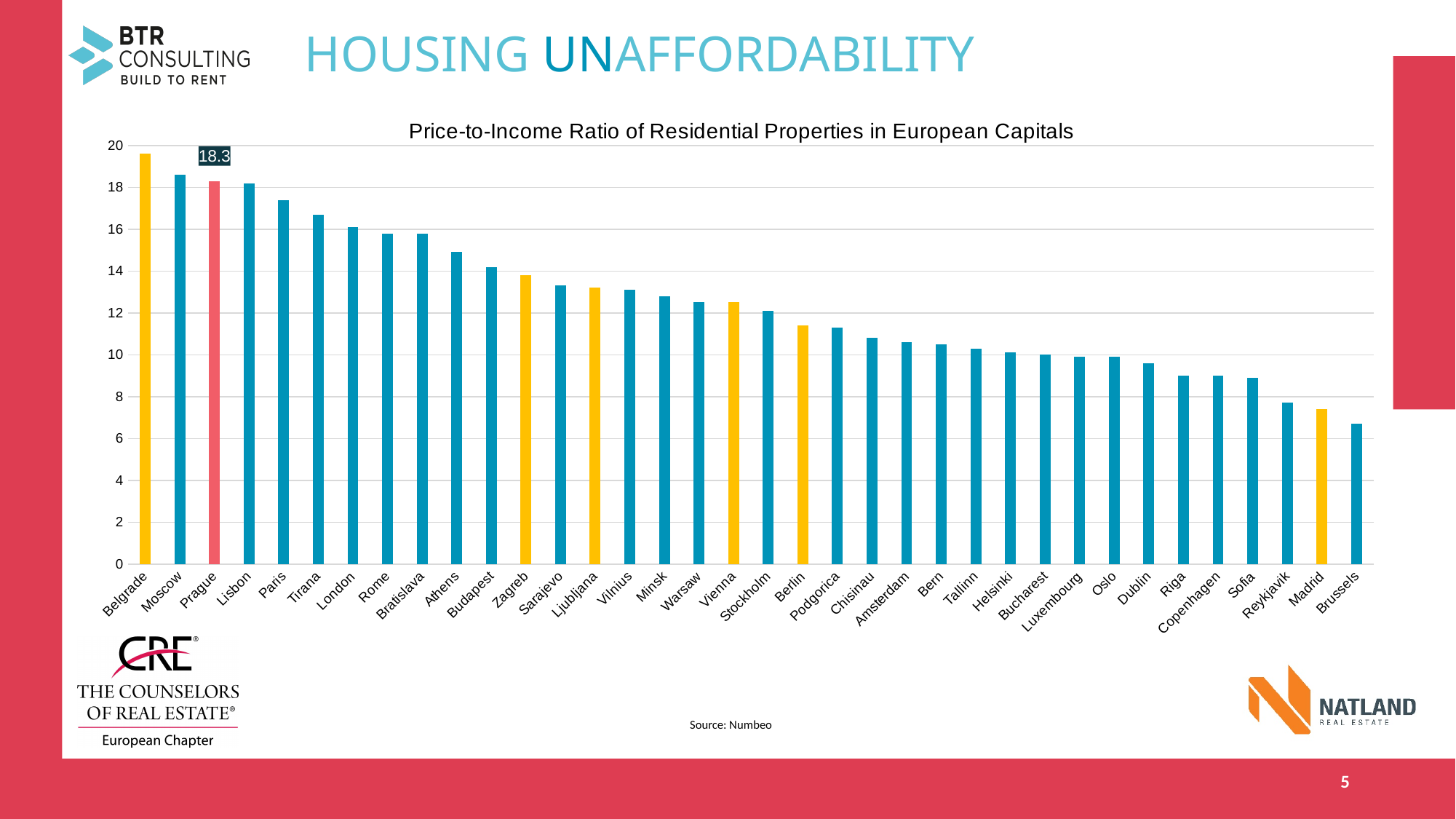
How many capitals are plotted in the chart? 36 What is the title of the chart? Price-to-Income Ratio of Residential Properties in European Capitals Which has the higher price-to-income ratio, Zagreb or Vienna? Zagreb Which capital has the highest price-to-income ratio in the chart? Belgrade Which capital has the lowest price-to-income ratio in the chart? Brussels What is the source cited for the chart data? Numbeo Is the value for Madrid greater or less than 8? less What is the price-to-income ratio shown for Prague? 18.3 Do the values rise or fall moving from left to right along the x axis? Fall Is the value for Belgrade greater or less than 18? greater Is the value for London greater or less than 14? greater What kind of chart is used to show the price-to-income ratios? Bar chart